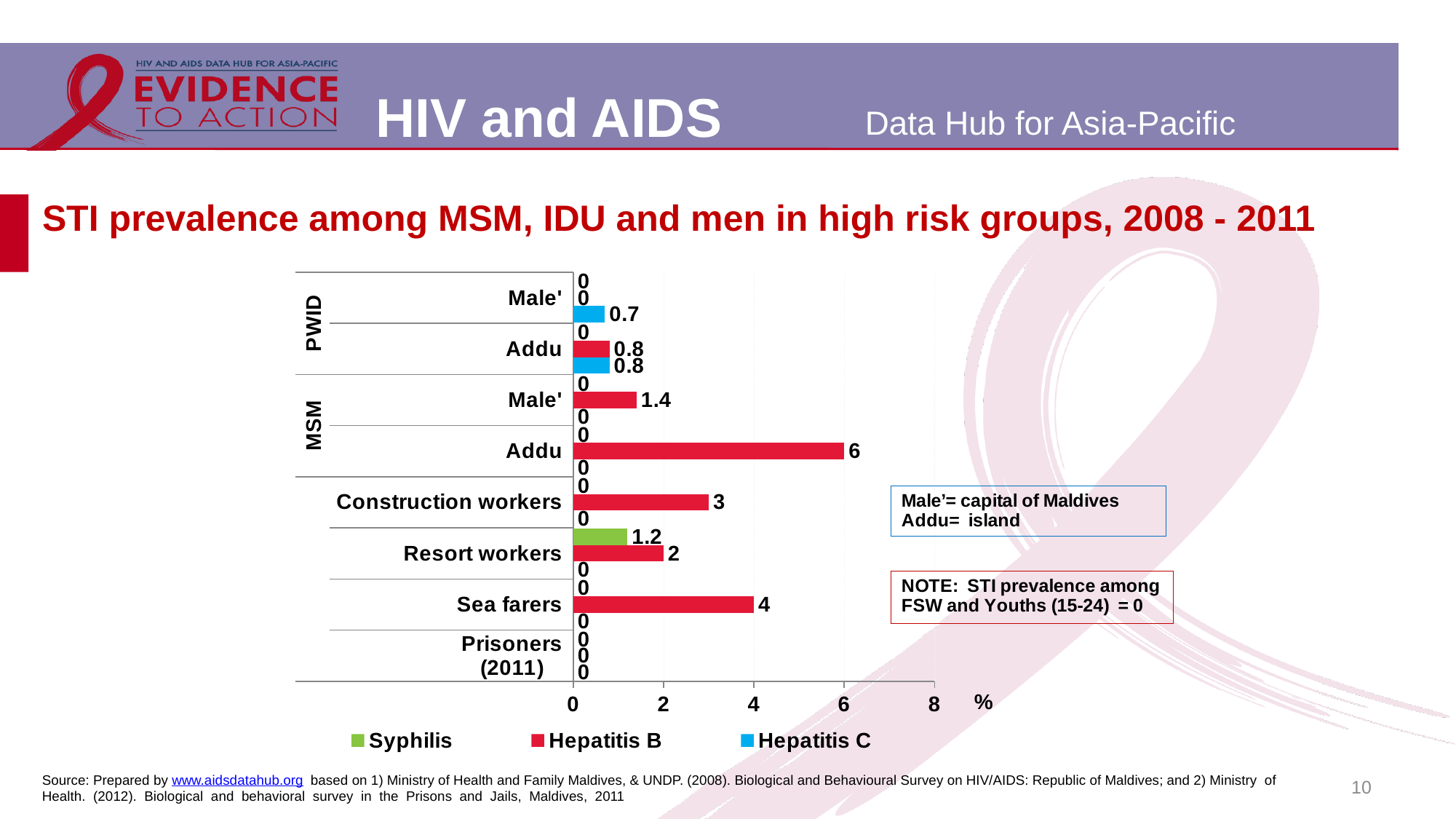
What is the difference between the Hepatitis B prevalence of Sea farers and Construction workers? 1 What is the Hepatitis B prevalence for MSM in Addu? 6 Which has a higher Hepatitis B prevalence, Sea farers or Construction workers? Sea farers How many series does the legend list? 3 What is the Hepatitis B prevalence among Sea farers? 4 What is the Syphilis prevalence among Resort workers? 1.2 Which group has the highest Hepatitis B prevalence? MSM Addu How many categories (groups) are plotted on the chart? 8 What is the Hepatitis C prevalence for PWID in Male'? 0.7 What colour represents Hepatitis C in the legend? blue Is the Hepatitis B value for MSM in Addu greater or less than 4? greater What kind of chart is shown on the slide? bar chart